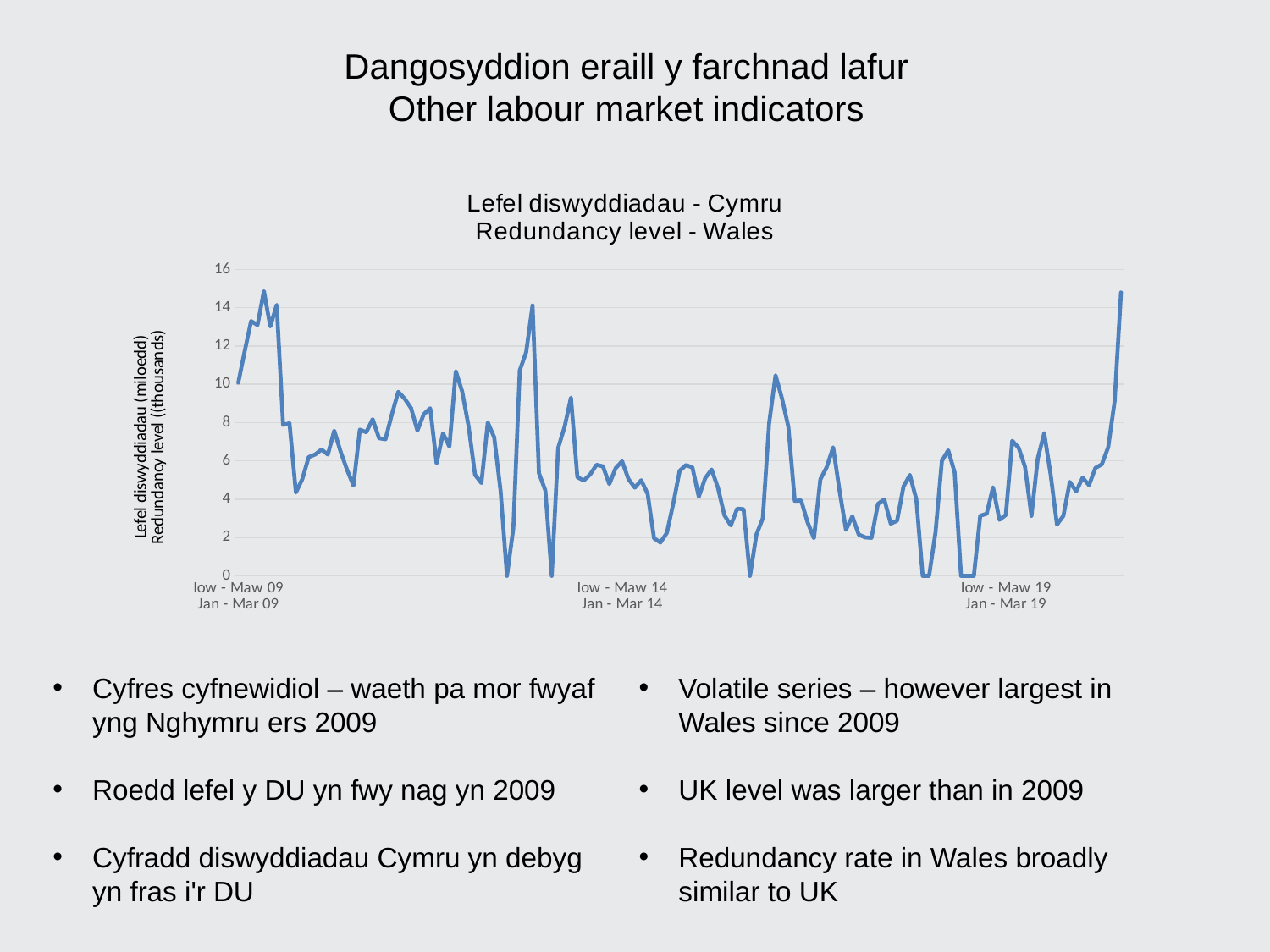
Is the value at Jan - Mar 14 greater or less than 10? less What is the English title of the chart? Redundancy level - Wales Is the value at Jan - Mar 09 greater or less than the value at Jan - Mar 19? greater How many period labels are printed along the horizontal axis? 3 Is the value at Jan - Mar 09 greater or less than 8? greater Is the value at Jan - Mar 19 greater or less than 8? less What kind of chart is shown on the slide? line chart What is the highest value shown on the vertical axis? 16 What is the English label on the vertical axis of the chart? Redundancy level ((thousands)